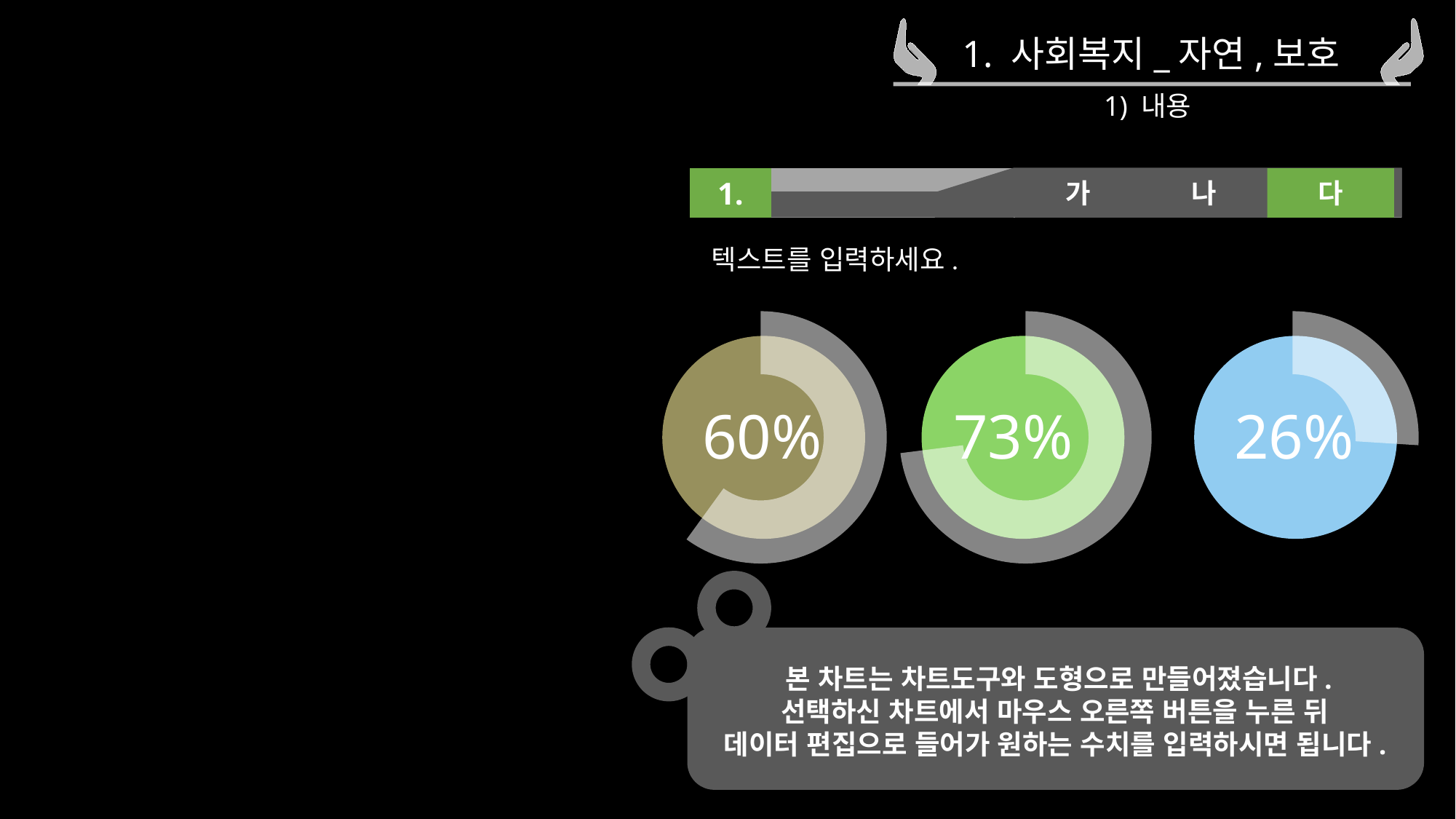
Which of the three circular charts shows the lowest percentage? The right chart (26%) Which of the three circular charts shows the highest percentage? The middle chart (73%) What kind of chart is used to display the three percentages? Pie (doughnut) chart What value is shown on the left circular chart? 60% What is the difference between the value on the left chart and the value on the right chart? 34% What value is shown on the right circular chart? 26% What value is shown on the middle circular chart? 73% What colour is the circular chart showing 26%? Blue How many circular percentage charts are shown on the slide? 3 What is the difference between the value on the middle chart and the value on the left chart? 13% Which is larger, the value on the left chart or the value on the right chart? The left chart (60%) Is the value on the right circular chart greater or less than 50%? less